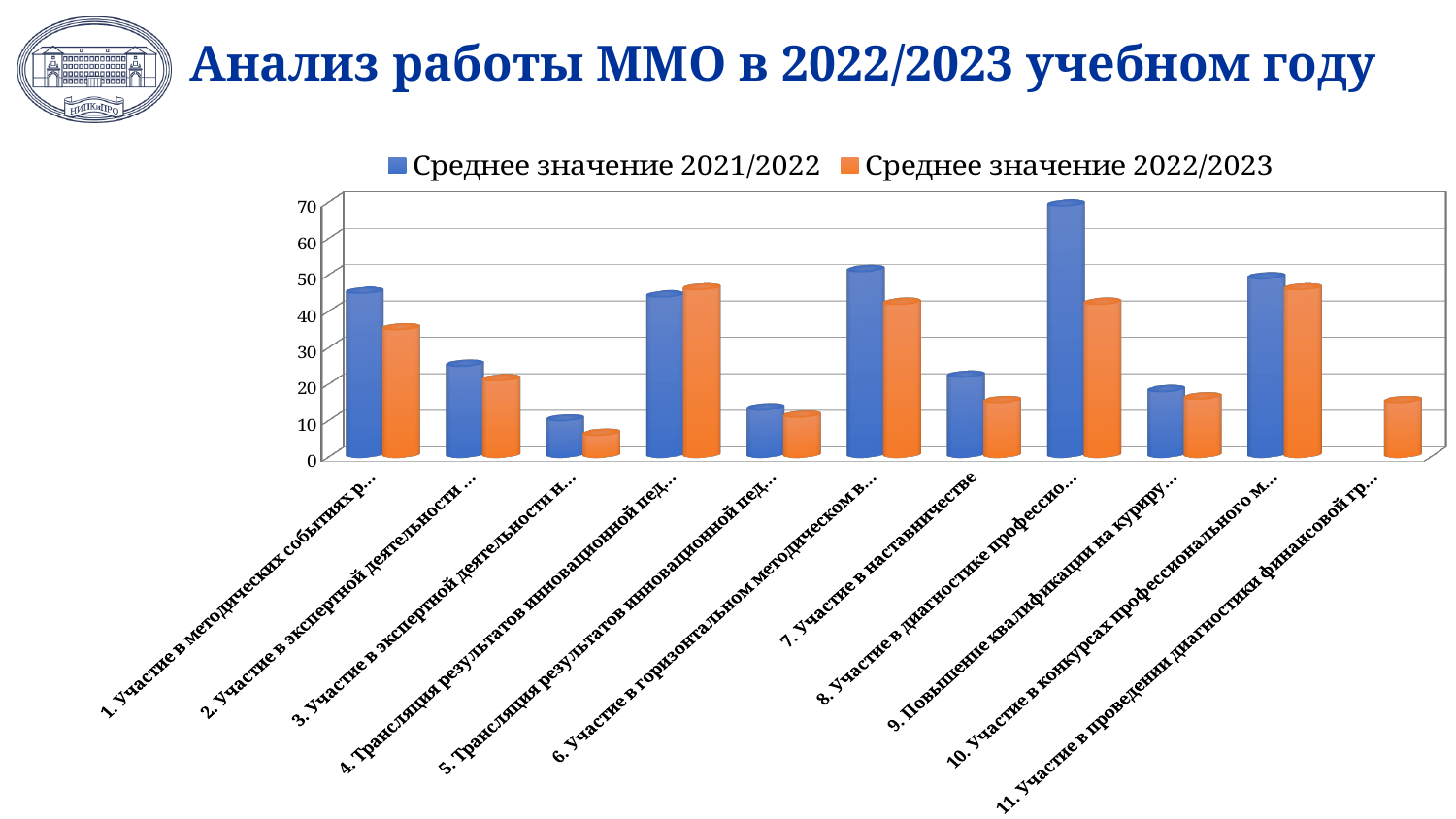
Which category has the highest value for the series "Среднее значение 2021/2022"? 8. Участие в диагностике профессио... How many categories are shown along the x axis? 11 For category 8, which series has the larger value: "Среднее значение 2021/2022" or "Среднее значение 2022/2023"? Среднее значение 2021/2022 For category 1, which series has the larger value: "Среднее значение 2021/2022" or "Среднее значение 2022/2023"? Среднее значение 2021/2022 Is the value for "7. Участие в наставничестве" in the series "Среднее значение 2022/2023" greater or less than 20? less Is the value for category 8 in the series "Среднее значение 2021/2022" greater or less than 60? greater Is the value for category 1 in the series "Среднее значение 2021/2022" greater or less than 40? greater How many series does the legend list? 2 What colour represents the series "Среднее значение 2022/2023"? orange Which category has the lowest value for the series "Среднее значение 2022/2023"? 3. Участие в экспертной деятельности н... What kind of chart is shown on the slide? bar chart